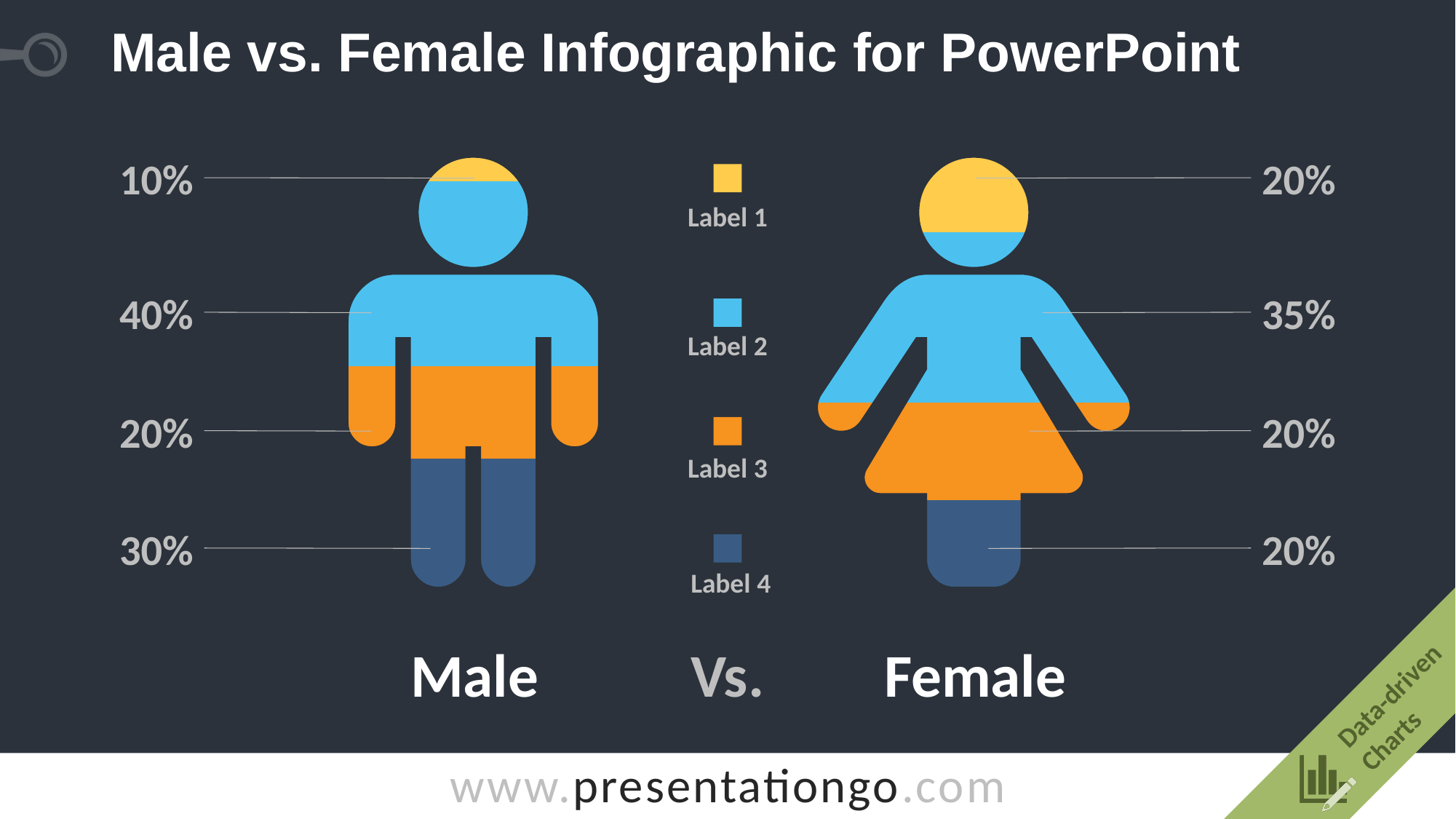
On the Male figure, which label has the lowest value? Label 1 What colour represents Label 3 in the legend? Orange On the Male figure, which label has the highest value? Label 2 On the Female figure, which label has the highest value? Label 2 What is the difference between the Male and Female values for Label 1? 10% Which is larger, the Male value for Label 2 or the Female value for Label 2? Male On the Male figure, what is the value for Label 1? 10% On the Female figure, what is the value for Label 2? 35% How many labels does the legend list? 4 On the Male figure, what is the value for Label 2? 40% On the Female figure, what is the value for Label 4? 20% What is the difference between the Male and Female values for Label 4? 10%